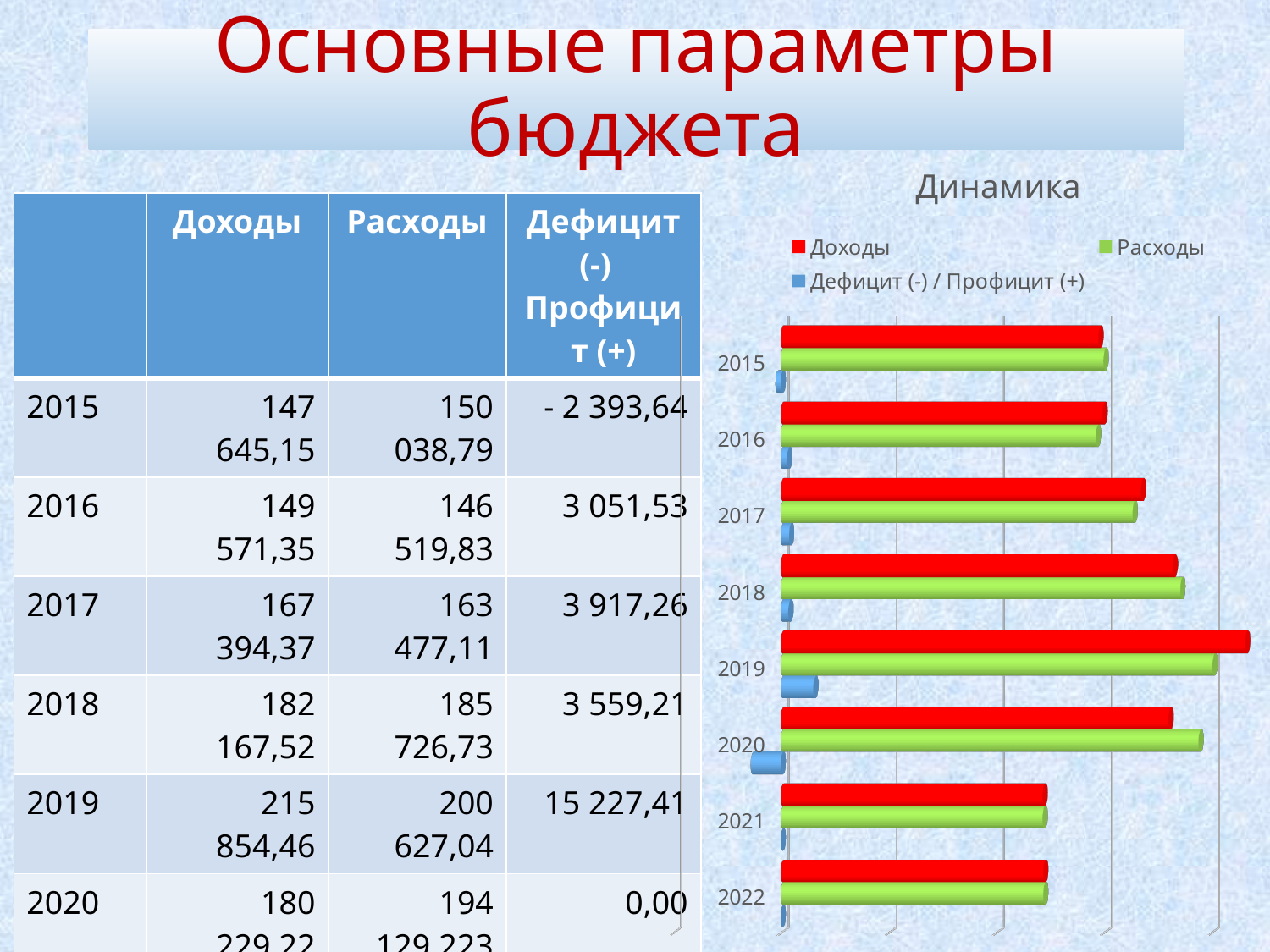
Which colour represents the Расходы series in the chart? green In the chart, for 2020, which is longer: the Доходы bar or the Расходы bar? Расходы Which year is listed first (at the top) on the chart's vertical axis? 2015 In the chart, for 2019, which is longer: the Доходы bar or the Расходы bar? Доходы What is the title of the chart on the slide? Динамика Which year has the longest Доходы bar in the chart? 2019 In the chart, is the Доходы bar for 2019 longer or shorter than the Доходы bar for 2020? longer What kind of chart is shown on the slide? bar chart How many series does the chart's legend list? 3 How many years are shown on the chart's vertical axis? 8